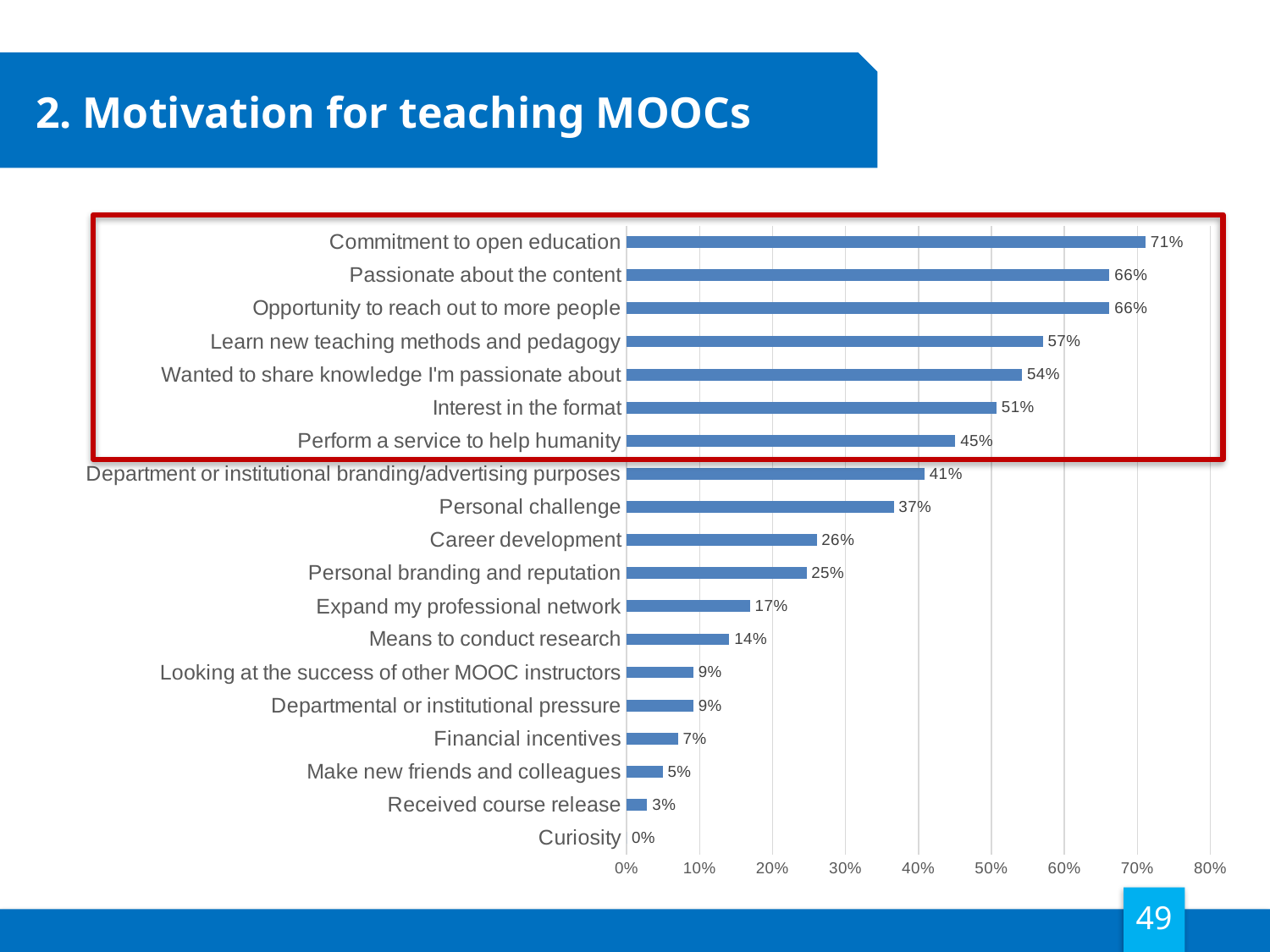
What is the value for "Means to conduct research"? 14% What is the difference between "Learn new teaching methods and pedagogy" and "Wanted to share knowledge I'm passionate about"? 3% What is the difference between "Commitment to open education" and "Perform a service to help humanity"? 26% How many categories are shown in the chart? 19 What is the value for "Interest in the format"? 51% What kind of chart is shown on the slide? Bar chart What is the title of the slide containing the chart? 2. Motivation for teaching MOOCs Which category has the lowest value? Curiosity Which category has the highest value? Commitment to open education Which is larger: "Personal challenge" or "Career development"? Personal challenge What is the value for "Commitment to open education"? 71% What is the value for "Financial incentives"? 7%